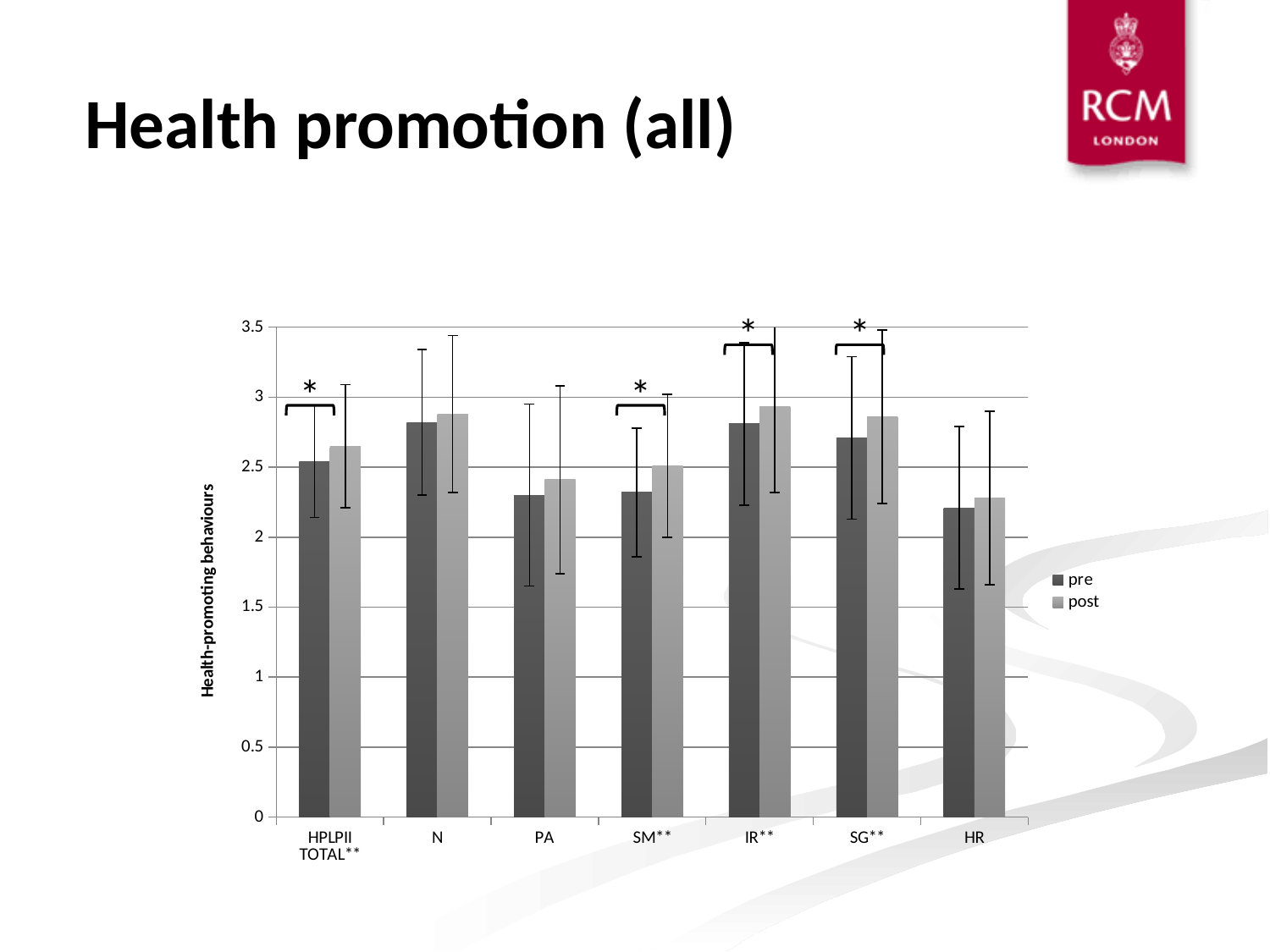
How many categories are shown along the x axis of the chart? 7 How many series does the chart's legend list? 2 Which category has the lowest post value? HR Is the post value for PA greater or less than 2.5? less Is the pre value for HR greater or less than 2.5? less What are the two series named in the legend? pre and post Which is larger, the pre value for N or the pre value for PA? N Is the pre value for N greater or less than 2.5? greater What kind of chart is shown on the slide? bar chart What is the label of the vertical axis? Health-promoting behaviours In each category, is the post bar higher or lower than the pre bar? higher